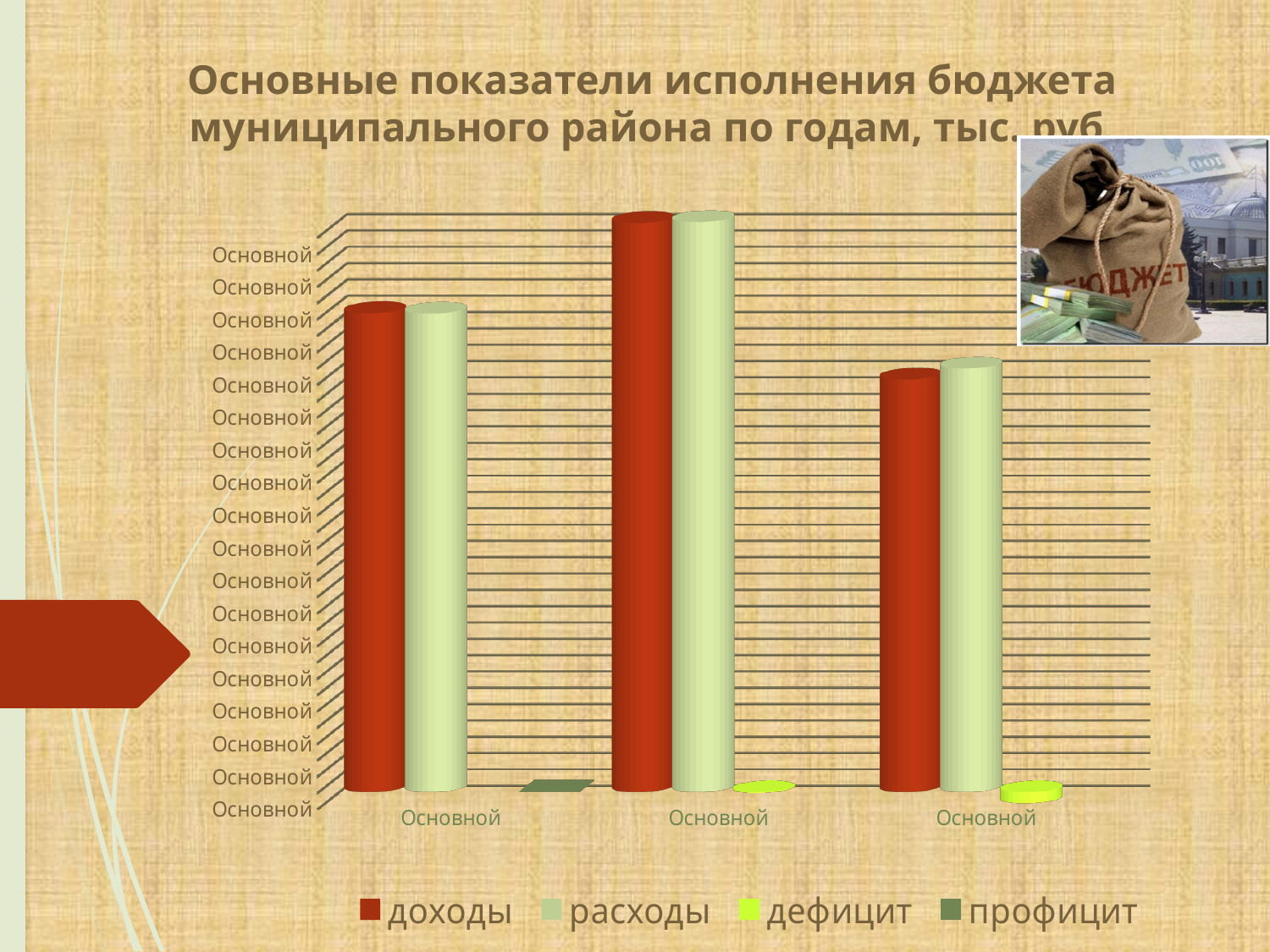
Does the расходы value rise or fall from the first group to the second group? rise Does the доходы value rise or fall from the second group to the third group? fall How many series does the chart legend list? 4 In the third group of bars, which is larger, доходы or расходы? расходы What colour are the доходы bars? red What kind of chart is shown on the slide? bar chart Which series appears only in the first group of bars? профицит Which group of bars (first, second or third) has the shortest доходы bar? third What are the series names listed in the legend? доходы, расходы, дефицит, профицит Which group of bars (first, second or third) has the tallest доходы bar? second How many groups of bars are plotted along the x axis? 3